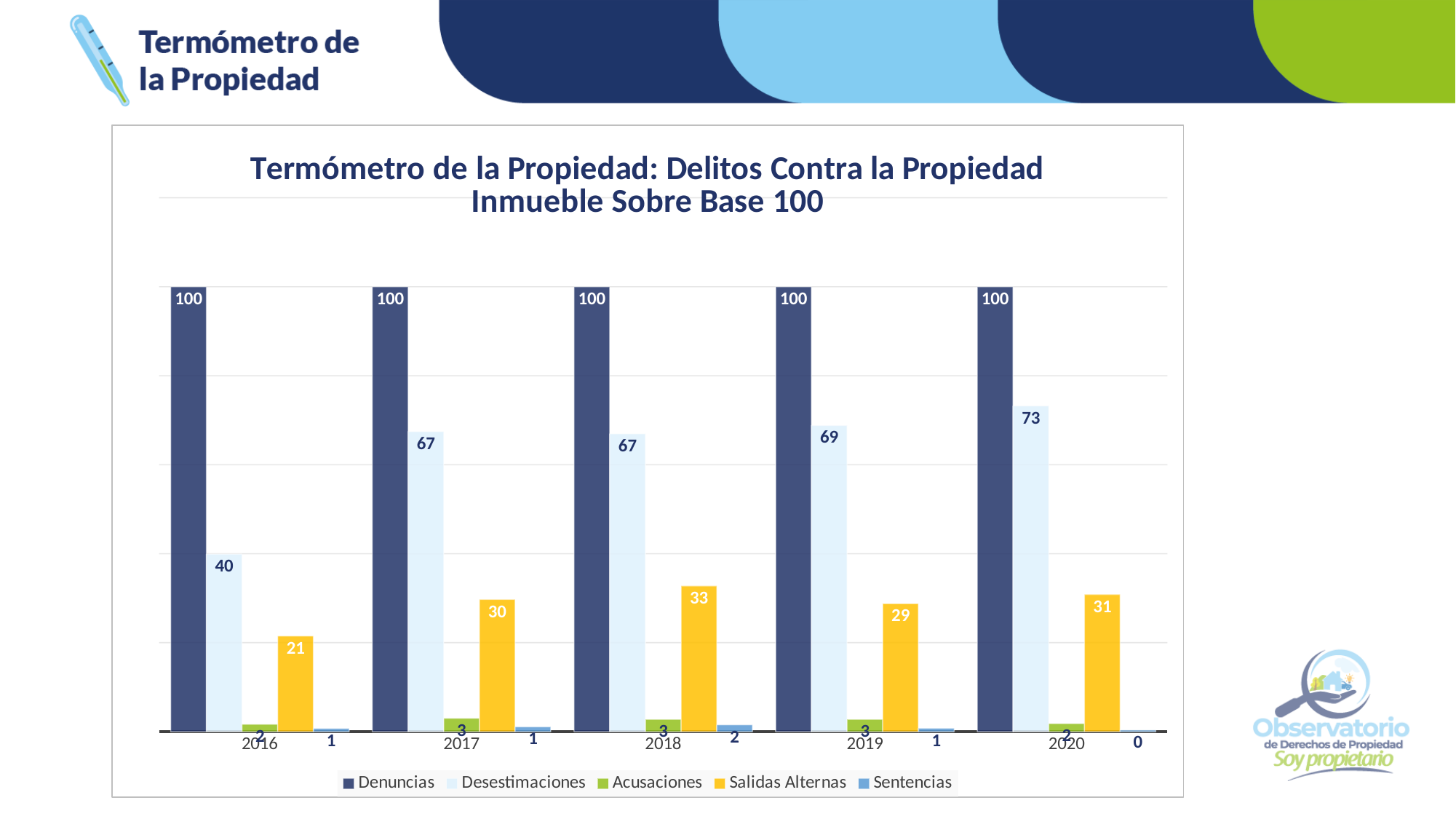
What is the value for Desestimaciones in 2016? 40 Does the value for Desestimaciones rise or fall from 2016 to 2020? Rise How many series does the legend list? 5 What is the difference between Desestimaciones in 2020 and in 2016? 33 How many years are shown on the x axis? 5 What is the value for Salidas Alternas in 2018? 33 What is the value for Sentencias in 2020? 0 Which is larger, Salidas Alternas in 2017 or Salidas Alternas in 2019? Salidas Alternas in 2017 What is the value for Acusaciones in 2017? 3 In which year is Desestimaciones highest? 2020 What kind of chart is shown on the slide? Bar chart In which year is Salidas Alternas lowest? 2016